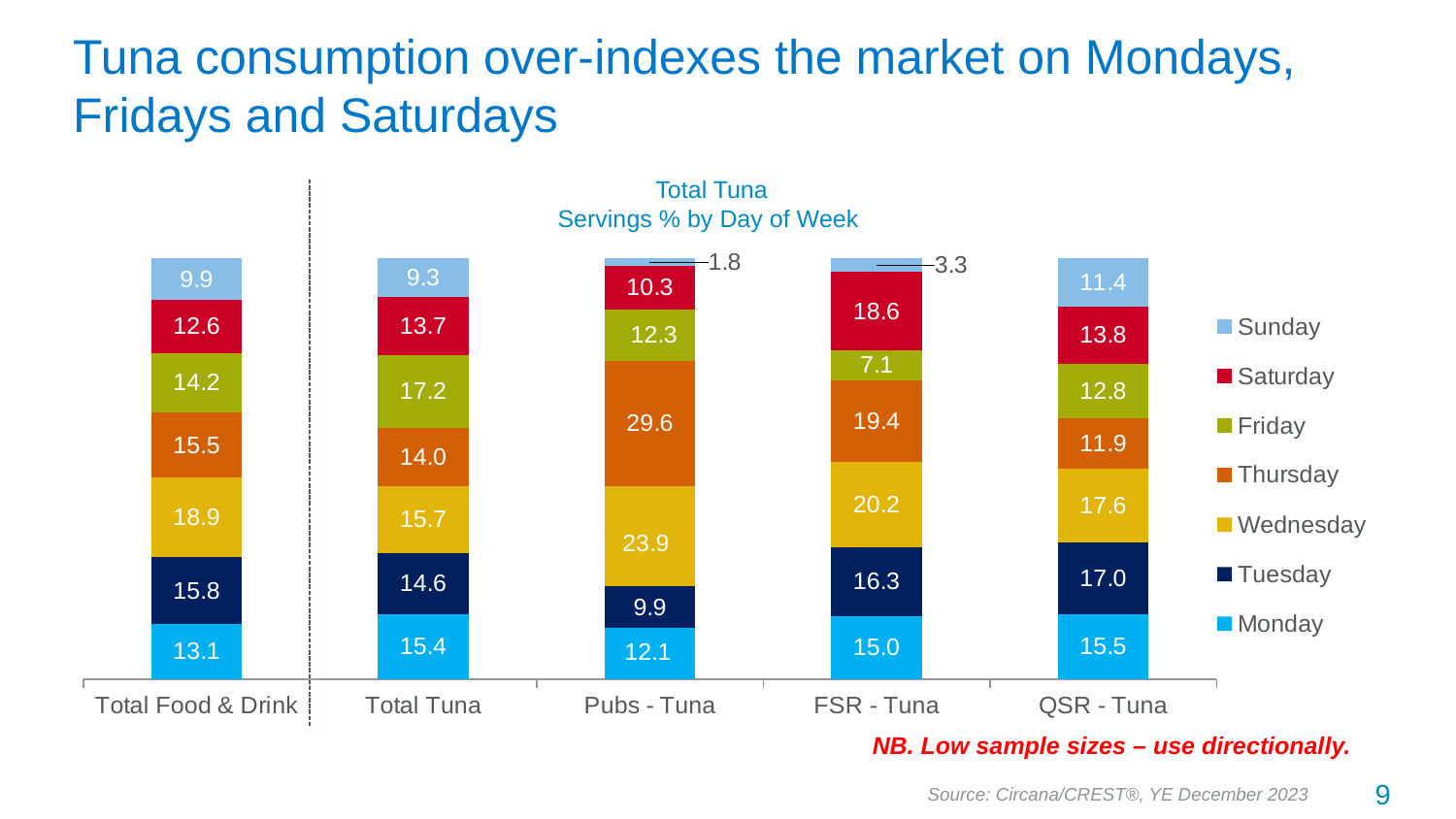
How many categories are shown on the x axis? 5 What is the Sunday value for FSR - Tuna? 3.3 What is the difference between the Friday value for Total Tuna and the Friday value for Total Food & Drink? 3.0 What is the Monday value for Total Tuna? 15.4 Which is larger, the Saturday value for FSR - Tuna or the Saturday value for Total Tuna? FSR - Tuna What is the title of the chart? Total Tuna Servings % by Day of Week What is the Saturday value for QSR - Tuna? 13.8 Which category has the highest Thursday value? Pubs - Tuna Which category has the lowest Sunday value? Pubs - Tuna What is the Wednesday value for Pubs - Tuna? 23.9 What kind of chart is shown on the slide? Stacked bar chart How many series does the legend list? 7